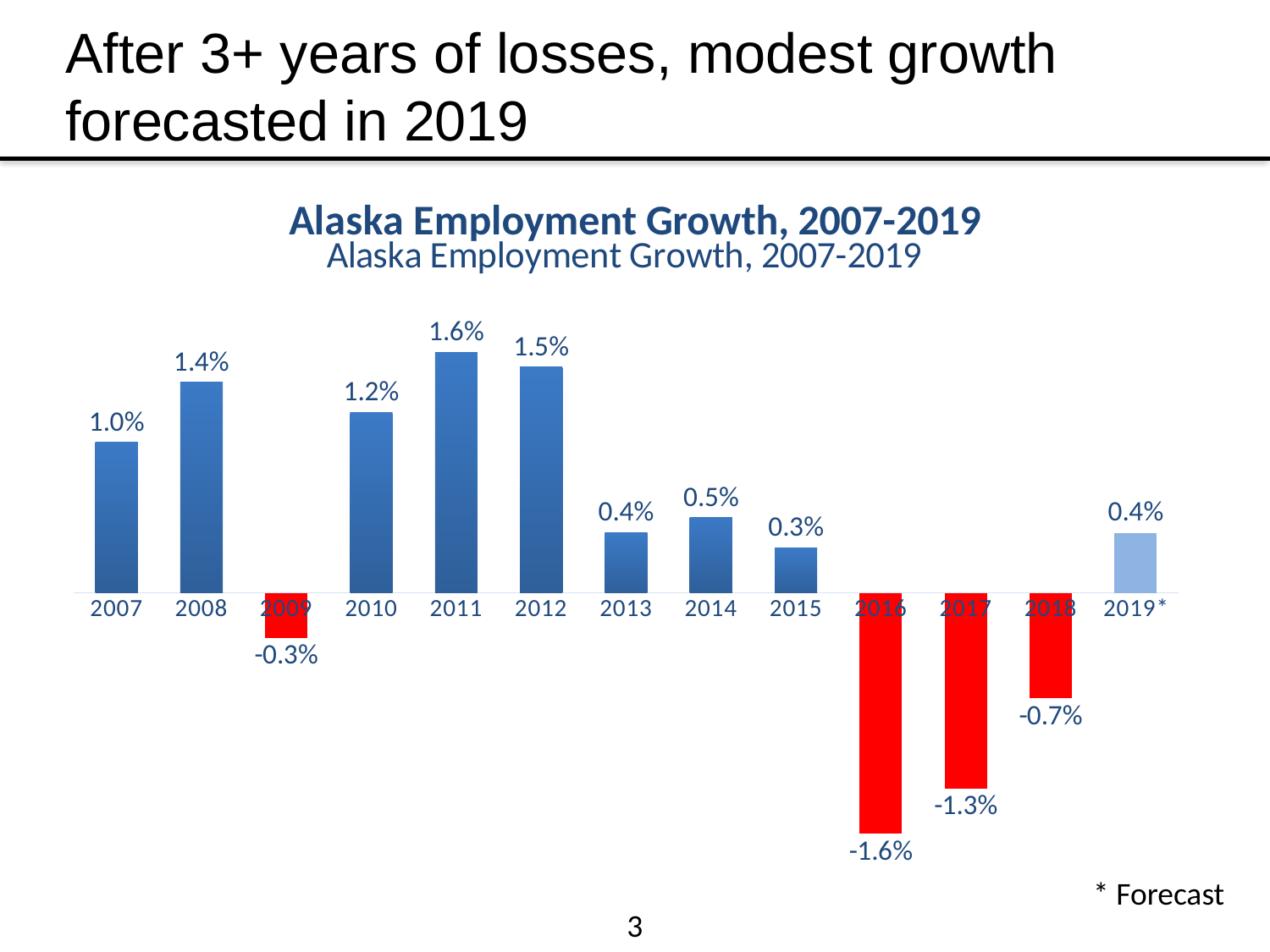
What is the employment growth value for 2011? 1.6% Which year has the lowest employment growth? 2016 How many years are shown on the x axis? 13 What is the employment growth value for 2016? -1.6% What kind of chart is shown on the slide? Bar chart What is the title of the chart? Alaska Employment Growth, 2007-2019 Which year has the highest employment growth? 2011 What is the forecasted employment growth value for 2019? 0.4% What is the difference between the 2008 and 2007 employment growth values? 0.4 percentage points How many years show negative employment growth? 4 Which year has the larger employment growth, 2010 or 2012? 2012 Do the employment growth values rise or fall from 2016 to 2018? Rise